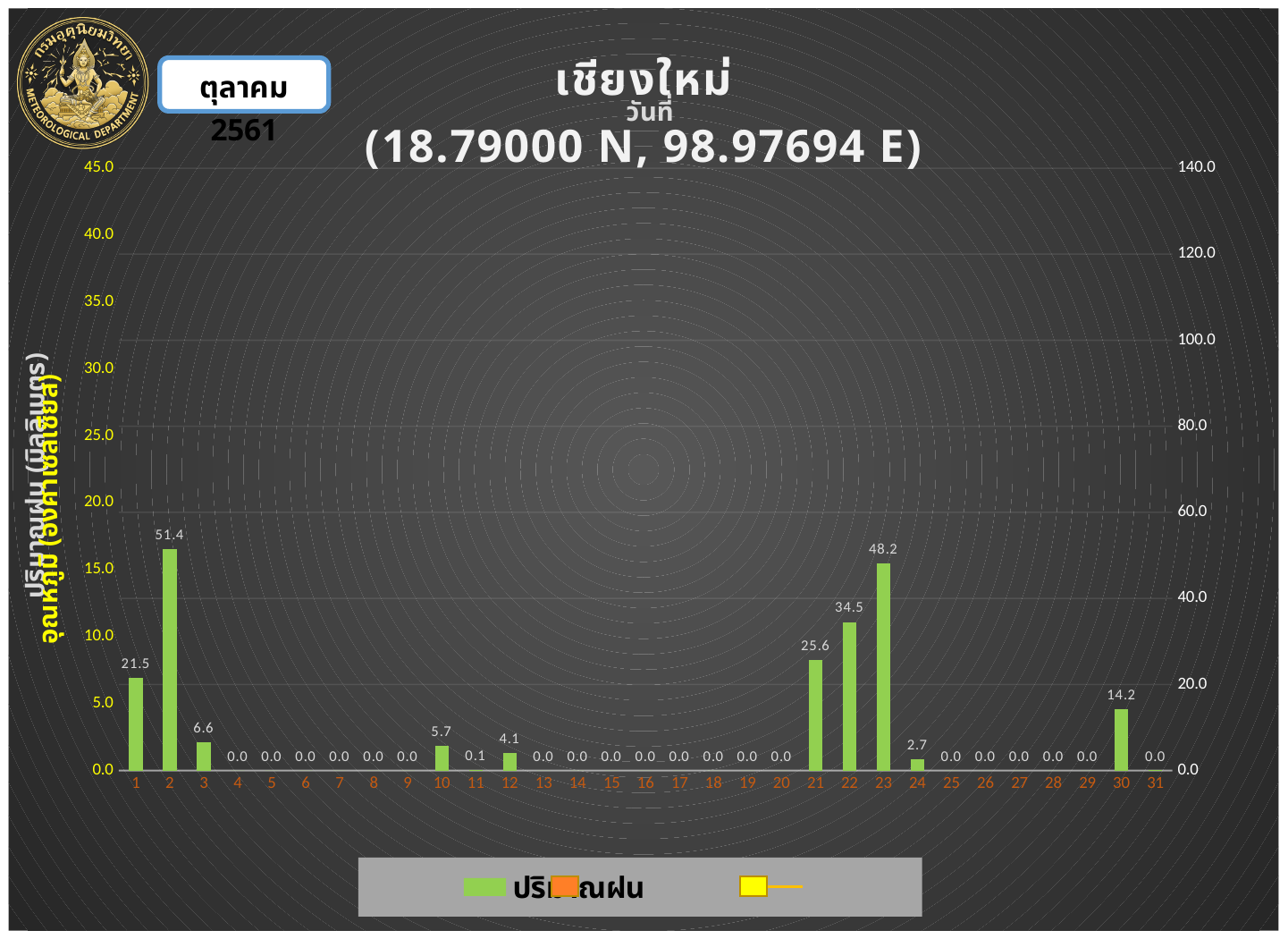
Is the rainfall value for day 22 greater or less than 40.0 on the right axis? less What is the rainfall value for day 11? 0.1 What is the rainfall value for day 30? 14.2 What is the rainfall value for day 2? 51.4 What kind of chart is shown on the slide? bar chart Which is larger, the rainfall value for day 1 or for day 21? day 21 Which day has the highest rainfall value? 2 What is the rainfall value for day 23? 48.2 How many days are shown on the x axis? 31 What coordinates are given in the chart title? 18.79000 N, 98.97694 E What is the difference between the rainfall values for day 22 and day 21? 8.9 What is the difference between the rainfall values for day 2 and day 23? 3.2